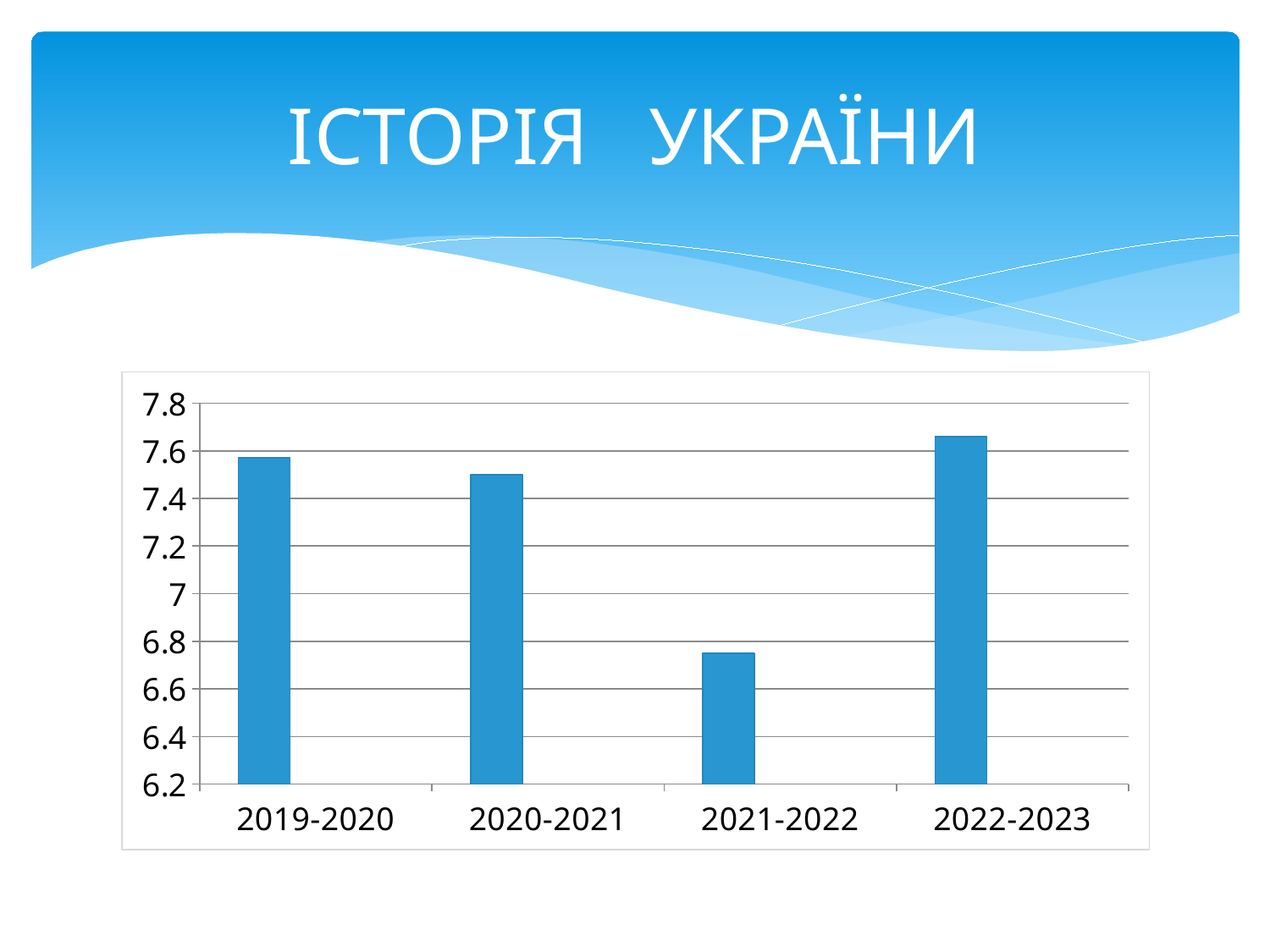
How many academic years (categories) are shown on the x axis of the chart? 4 Does the value rise or fall from 2021-2022 to 2022-2023? rise Is the value for 2022-2023 greater or less than 7.6? greater Which academic year has the highest bar in the chart? 2022-2023 Which academic year has the lowest bar in the chart? 2021-2022 Is the value for 2021-2022 greater or less than 7? less Is the value for 2020-2021 greater or less than 7.6? less Which is larger, the value for 2020-2021 or the value for 2021-2022? 2020-2021 What kind of chart is shown on the slide? bar chart What is the lowest value shown on the vertical axis of the chart? 6.2